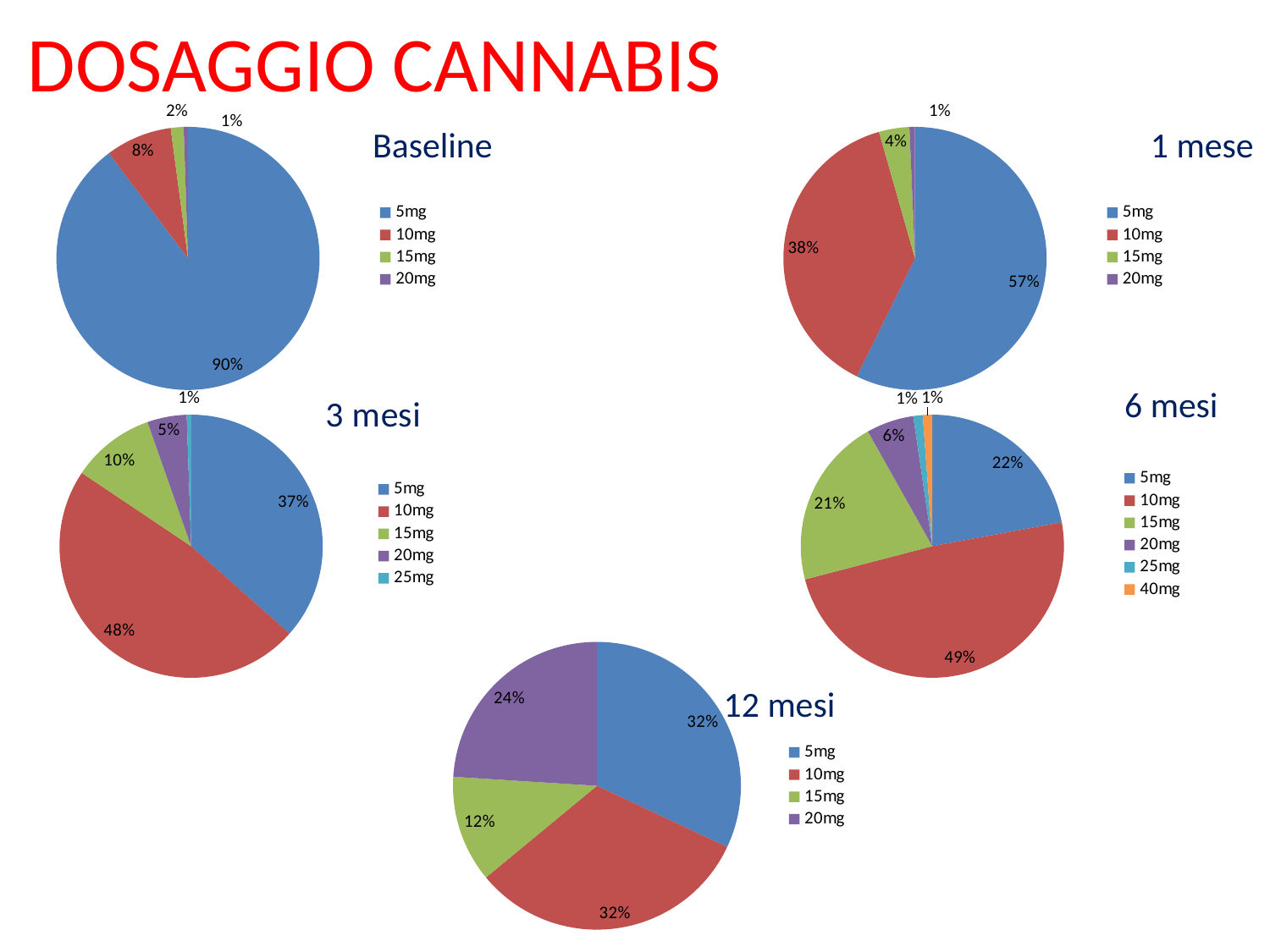
In the Baseline pie chart, what share is shown for 5mg? 90% In the 1 mese pie chart, what is the difference between the 5mg share and the 10mg share? 19% How many pie charts are shown on the slide? 5 In the 6 mesi pie chart, what share is shown for 20mg? 6% In the 6 mesi pie chart, which dose has the largest share? 10mg In the 12 mesi pie chart, which is larger: the share for 15mg or the share for 20mg? 20mg In the 1 mese pie chart, what share is shown for 10mg? 38% What type of chart is used for the 12 mesi data? Pie chart In the 3 mesi pie chart, what share is shown for 15mg? 10% In the 12 mesi pie chart, what share is shown for 20mg? 24% How many legend entries does the 6 mesi pie chart list? 6 In the 3 mesi pie chart, which dose has the smallest share? 25mg